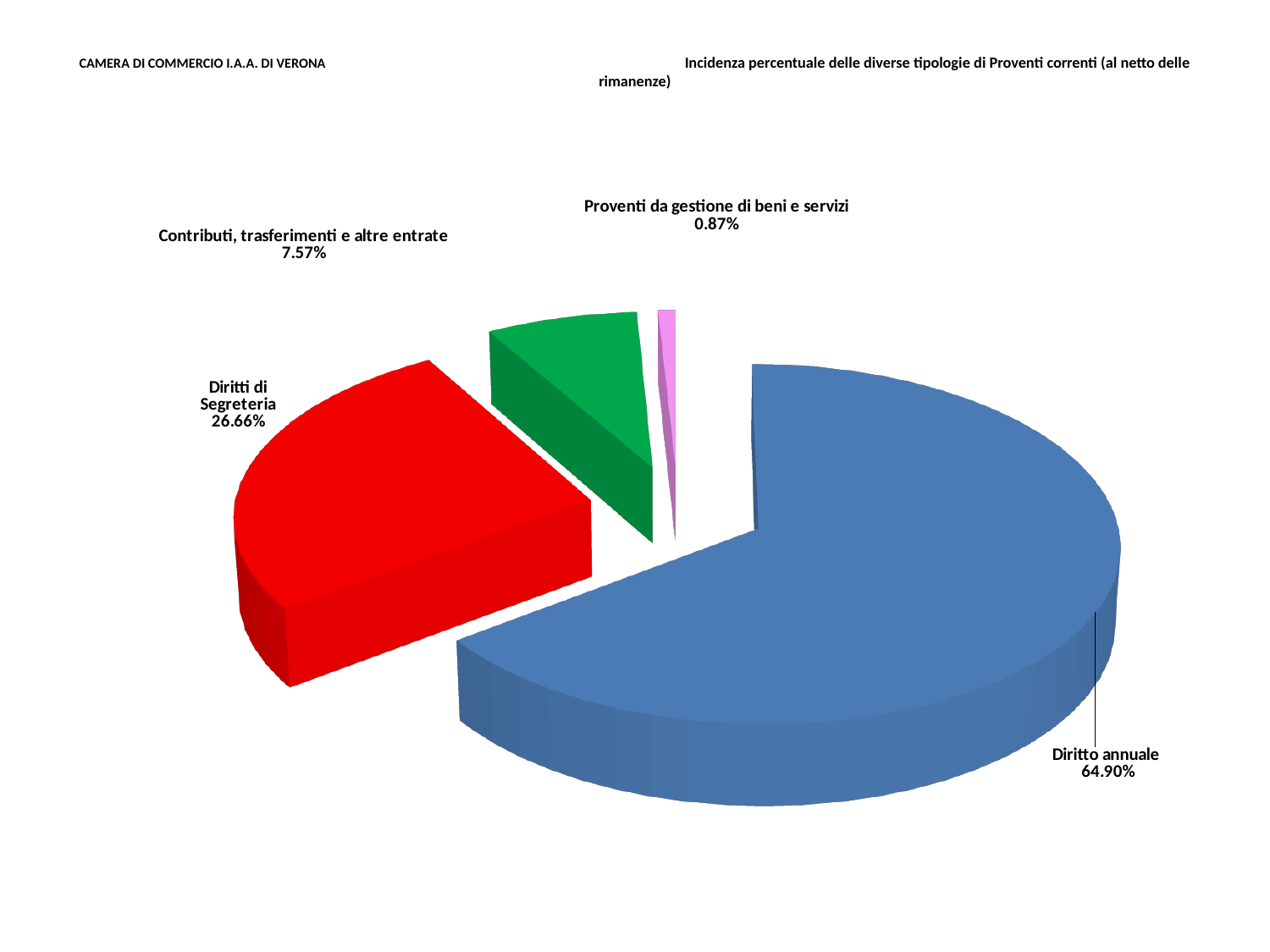
Which is larger: the share of Contributi, trasferimenti e altre entrate or the share of Proventi da gestione di beni e servizi? Contributi, trasferimenti e altre entrate What type of chart is shown on the slide? Pie chart What is the share shown for Proventi da gestione di beni e servizi? 0.87% How many slices does the pie chart have? 4 What is the title of the chart? Incidenza percentuale delle diverse tipologie di Proventi correnti (al netto delle rimanenze) What percentage share does Diritti di Segreteria have? 26.66% What is the difference in percentage points between Diritto annuale and Diritti di Segreteria? 38.24 What percentage share does Diritto annuale have in the pie chart? 64.90% What is the share shown for Contributi, trasferimenti e altre entrate? 7.57% Which category has the smallest share of the pie? Proventi da gestione di beni e servizi Which category has the largest share of the pie? Diritto annuale What colour is the slice for Diritti di Segreteria? Red